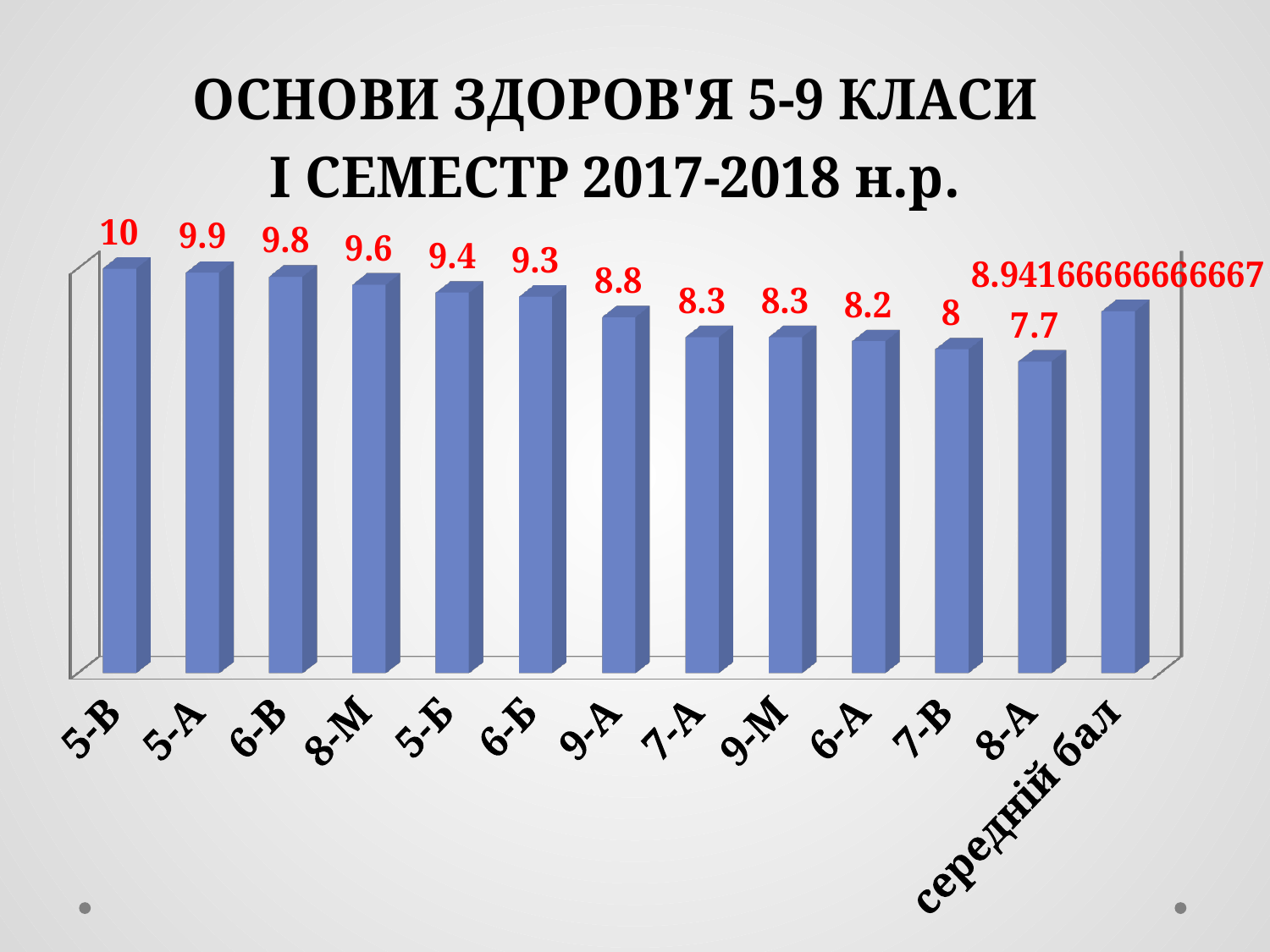
Which class has the lowest value? 8-А Which is larger, the value for 5-Б or the value for 6-А? 5-Б What is the value for 9-А? 8.8 How many bars are shown in the chart? 13 What is the value for 7-В? 8 What is the value for 5-В? 10 What is the difference between the values for 6-В and 6-Б? 0.5 What is the value for 8-М? 9.6 What is the value shown for середній бал? 8.94166666666667 What kind of chart is shown on the slide? bar chart What is the difference between the values for 5-В and 8-А? 2.3 Which class has the highest value? 5-В